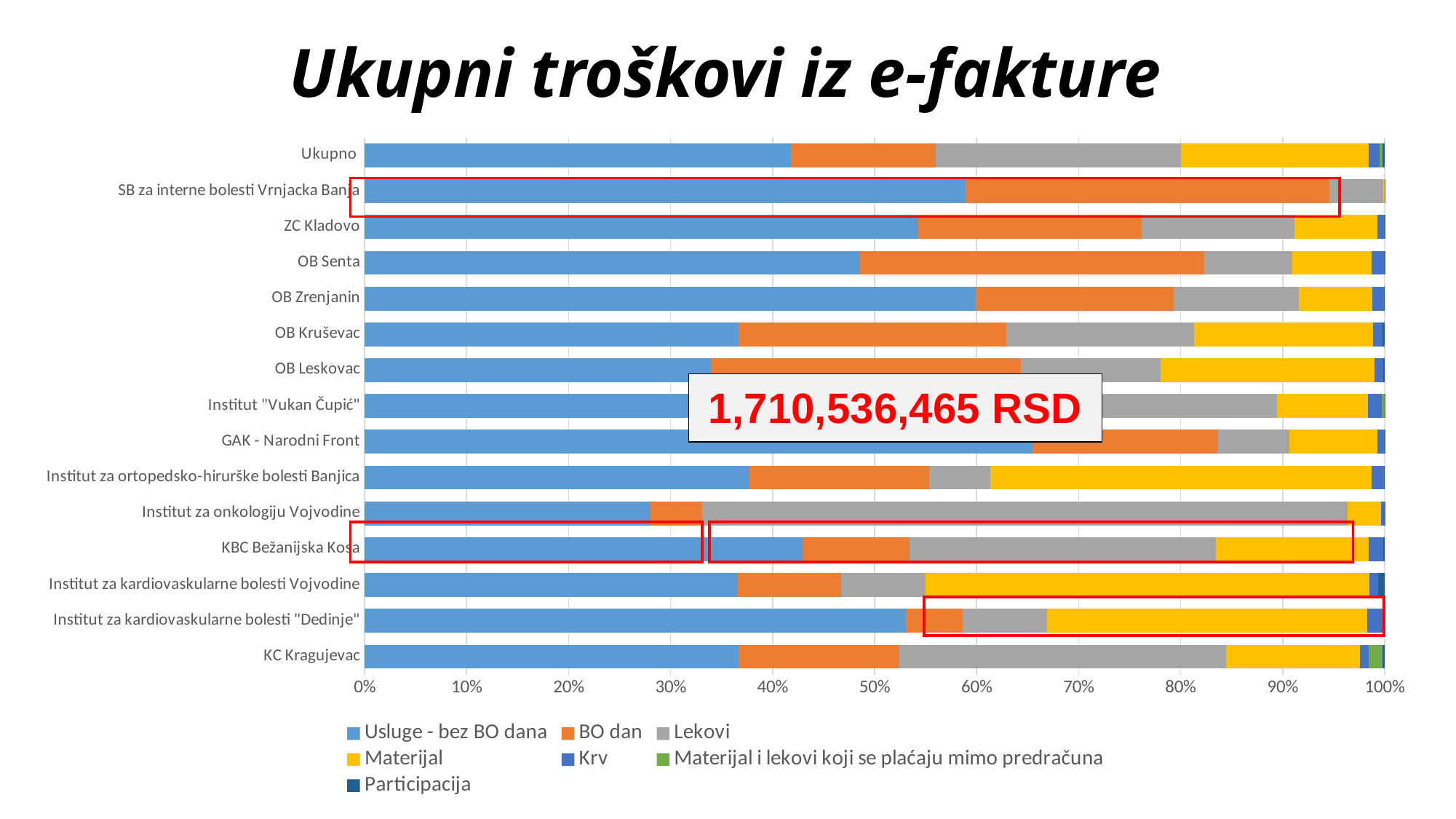
How many categories (institutions, including Ukupno) are plotted on the chart? 15 Which category has the largest 'BO dan' share? SB za interne bolesti Vrnjacka Banja Is the 'Usluge - bez BO dana' share for OB Leskovac greater or less than 40%? less How many series does the legend list? 7 Which category has the largest 'Lekovi' share? Institut za onkologiju Vojvodine Is the 'Usluge - bez BO dana' share for Institut za kardiovaskularne bolesti "Dedinje" greater or less than 50%? greater Is the 'Usluge - bez BO dana' share for Institut za onkologiju Vojvodine greater or less than 30%? less Which colour represents the 'Materijal' series in the legend? Yellow What is the title of the chart on the slide? Ukupni troškovi iz e-fakture What kind of chart is shown on the slide? Stacked bar chart Which has the larger 'Usluge - bez BO dana' share, OB Kruševac or OB Zrenjanin? OB Zrenjanin